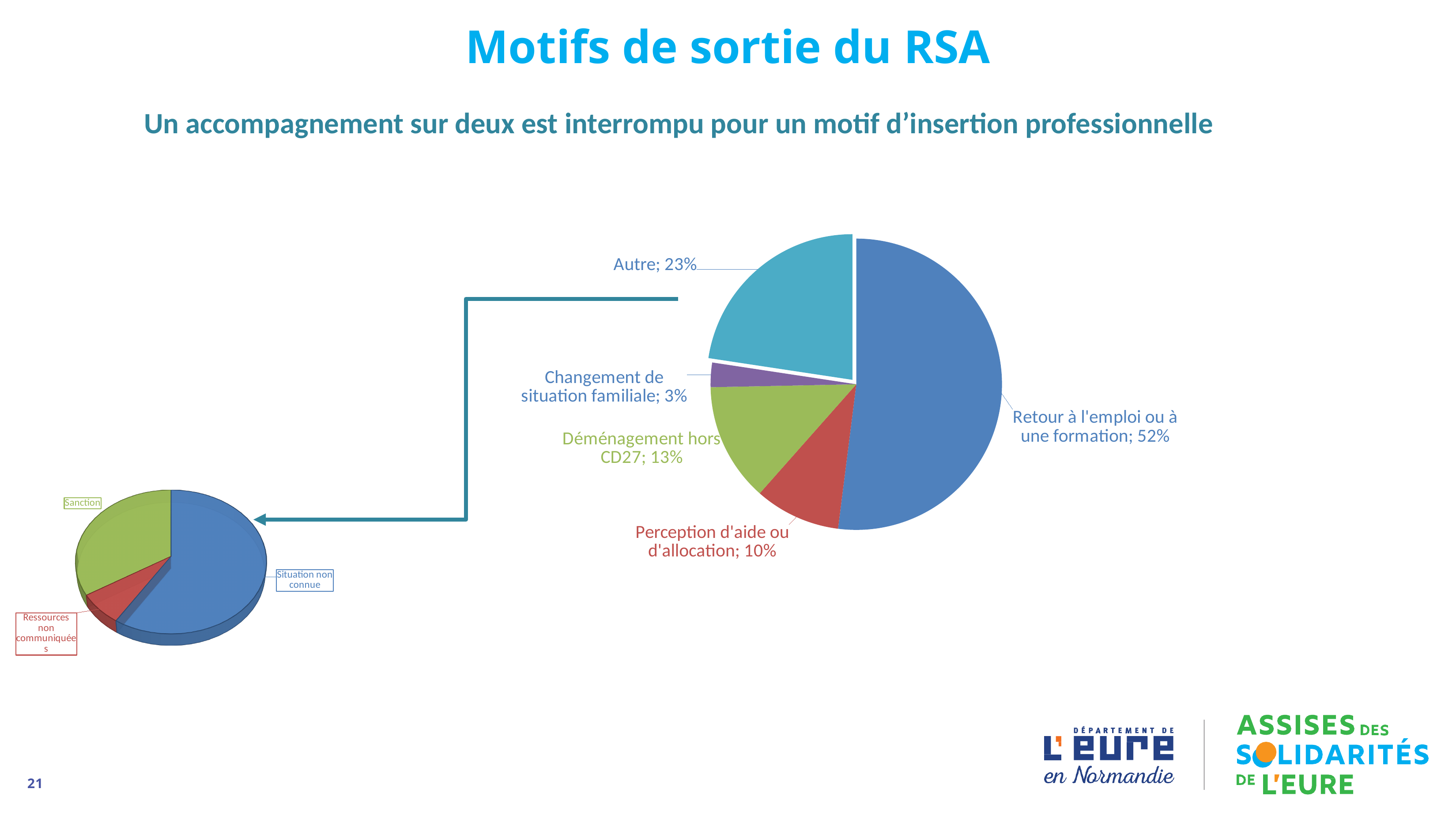
What type of chart is the small chart in the lower left of the slide? Pie chart In the large pie chart on the right, what share is labelled for "Retour à l'emploi ou à une formation"? 52% In the large pie chart on the right, what share is labelled for "Déménagement hors CD27"? 13% In the large pie chart on the right, which category has the largest slice? Retour à l'emploi ou à une formation How many slices does the large pie chart on the right have? 5 In the large pie chart on the right, which is larger: "Déménagement hors CD27" or "Perception d'aide ou d'allocation"? Déménagement hors CD27 In the large pie chart on the right, what share is labelled for "Changement de situation familiale"? 3% In the large pie chart on the right, which category has the smallest slice? Changement de situation familiale How many slices does the small pie chart in the lower left have? 3 In the large pie chart on the right, what share is labelled for "Autre"? 23% In the small pie chart in the lower left, which category has the largest slice? Situation non connue In the large pie chart on the right, what is the difference in percentage points between "Autre" and "Perception d'aide ou d'allocation"? 13